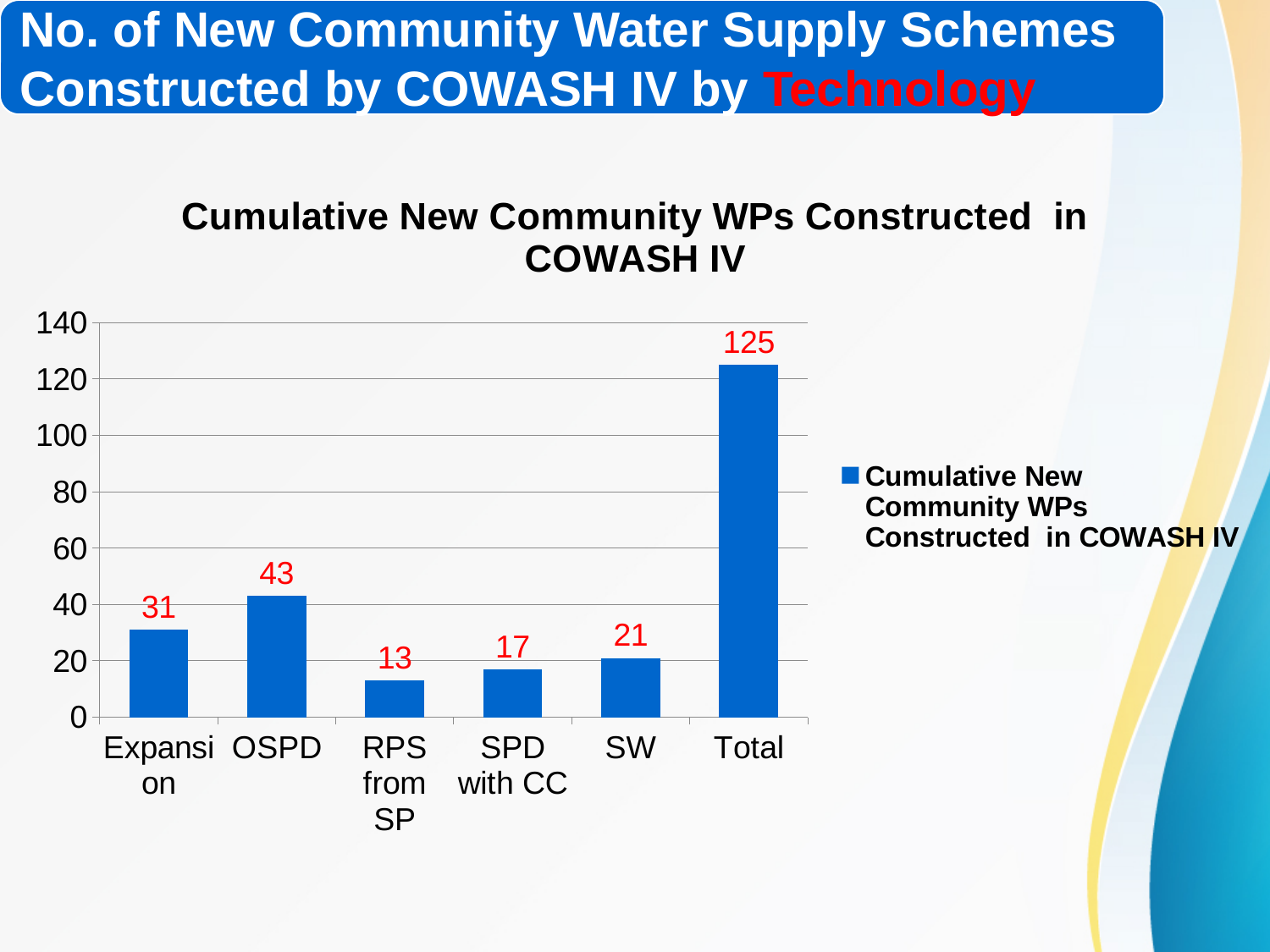
Which is larger, the value for SPD with CC or the value for SW? SW What is the value shown for the Total bar? 125 Is the value for Total greater or less than 120? greater What is the value for RPS from SP? 13 Which category has the lowest value? RPS from SP What is the title of the chart? Cumulative New Community WPs Constructed in COWASH IV What is the value for SW? 21 What kind of chart is shown on the slide? Bar chart How many categories are shown on the x axis? 6 What is the difference between the values for OSPD and Expansion? 12 What is the value for OSPD? 43 Excluding the Total bar, which technology category has the highest value? OSPD